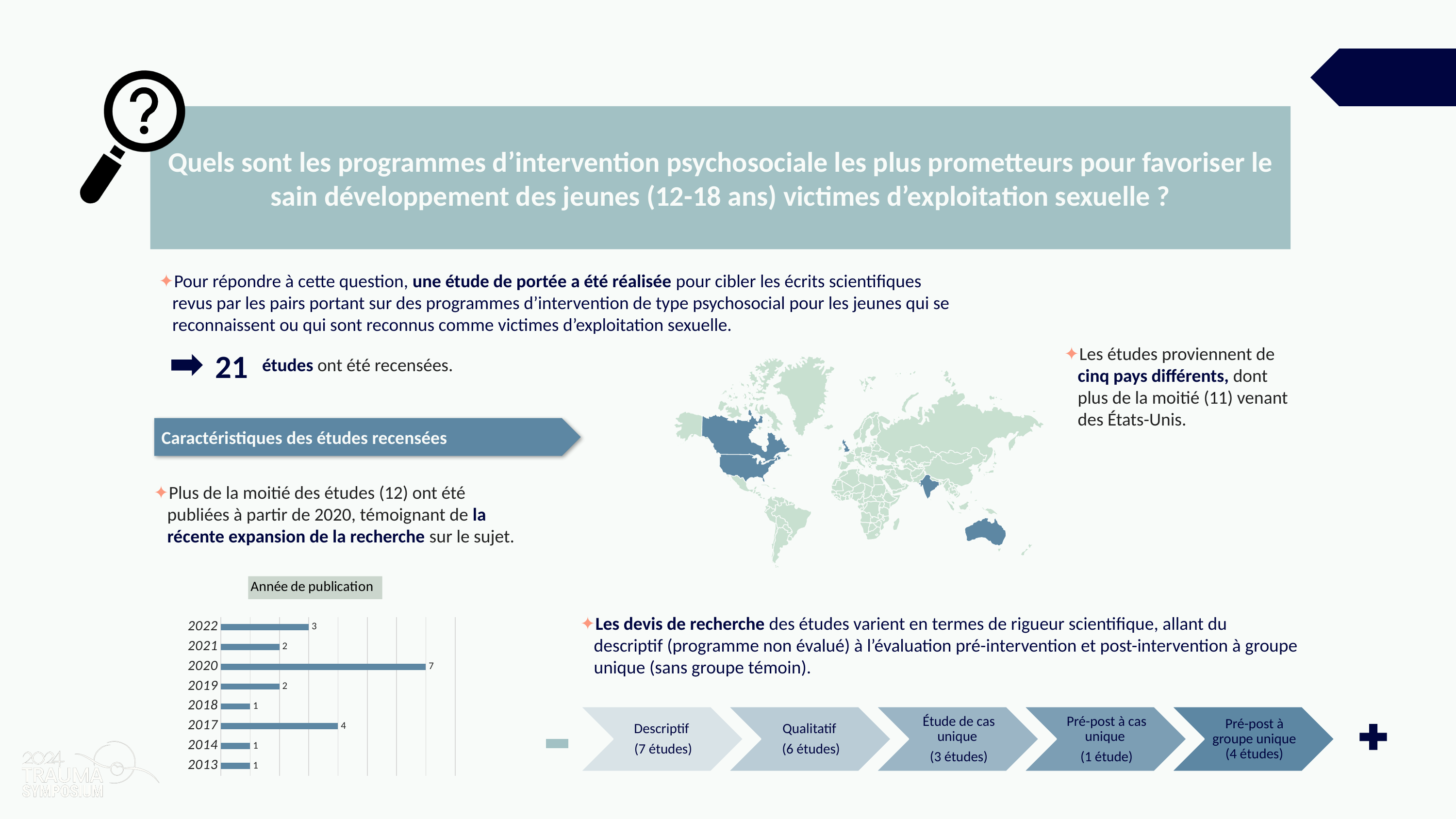
In the 'Année de publication' chart, what is the value for 2017? 4 In the 'Année de publication' chart, which year has the highest value? 2020 In the 'Année de publication' chart, which years have a value of 1? 2018, 2014, 2013 In the 'Année de publication' chart, how many years are shown? 8 What kind of chart is the 'Année de publication' chart? Bar chart What is the title of the bar chart on the slide? Année de publication In the 'Année de publication' chart, which is larger, the value for 2022 or the value for 2021? 2022 In the 'Année de publication' chart, what is the total of the values for 2013, 2014 and 2018? 3 In the 'Année de publication' chart, what is the difference between the values for 2020 and 2017? 3 In the 'Année de publication' chart, what is the value for 2022? 3 In the 'Année de publication' chart, how many studies were published in 2020? 7 In the 'Année de publication' chart, what is the difference between the values for 2022 and 2019? 1